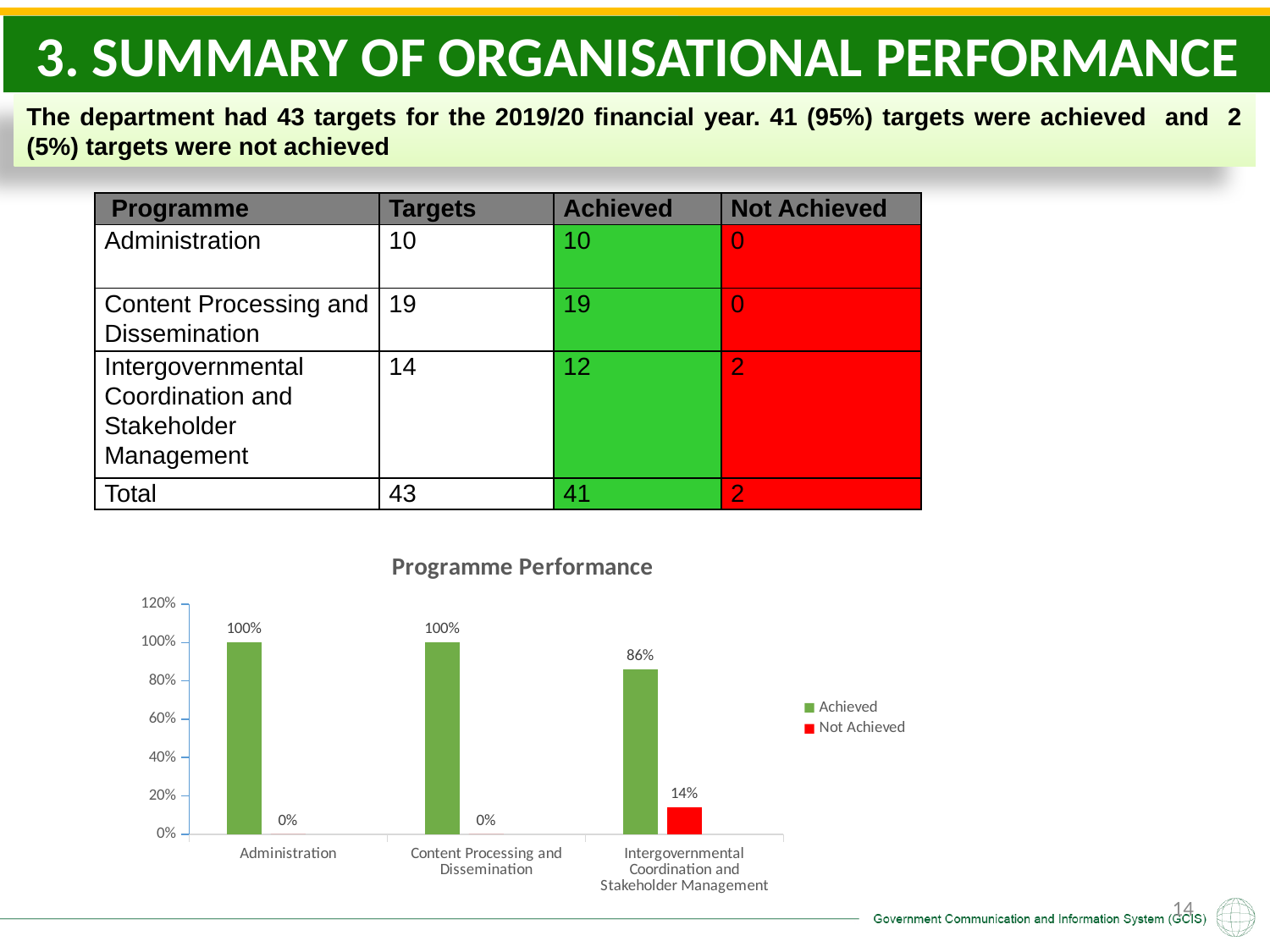
What is the difference between the Achieved values for Administration and Intergovernmental Coordination and Stakeholder Management in the Programme Performance chart? 14% What is the Achieved value for Intergovernmental Coordination and Stakeholder Management in the Programme Performance chart? 86% What is the Not Achieved value for Intergovernmental Coordination and Stakeholder Management in the Programme Performance chart? 14% In the Programme Performance chart, is the Achieved value for Content Processing and Dissemination larger or smaller than that for Intergovernmental Coordination and Stakeholder Management? larger What is the Not Achieved value for Content Processing and Dissemination in the Programme Performance chart? 0% What colour represents the Not Achieved series in the Programme Performance chart? red What is the Achieved value for Administration in the Programme Performance chart? 100% What kind of chart is the Programme Performance chart? bar chart How many series does the legend of the Programme Performance chart list? 2 Which programme has the highest Not Achieved value in the Programme Performance chart? Intergovernmental Coordination and Stakeholder Management Which programme has the lowest Achieved value in the Programme Performance chart? Intergovernmental Coordination and Stakeholder Management How many programmes are shown on the x axis of the Programme Performance chart? 3